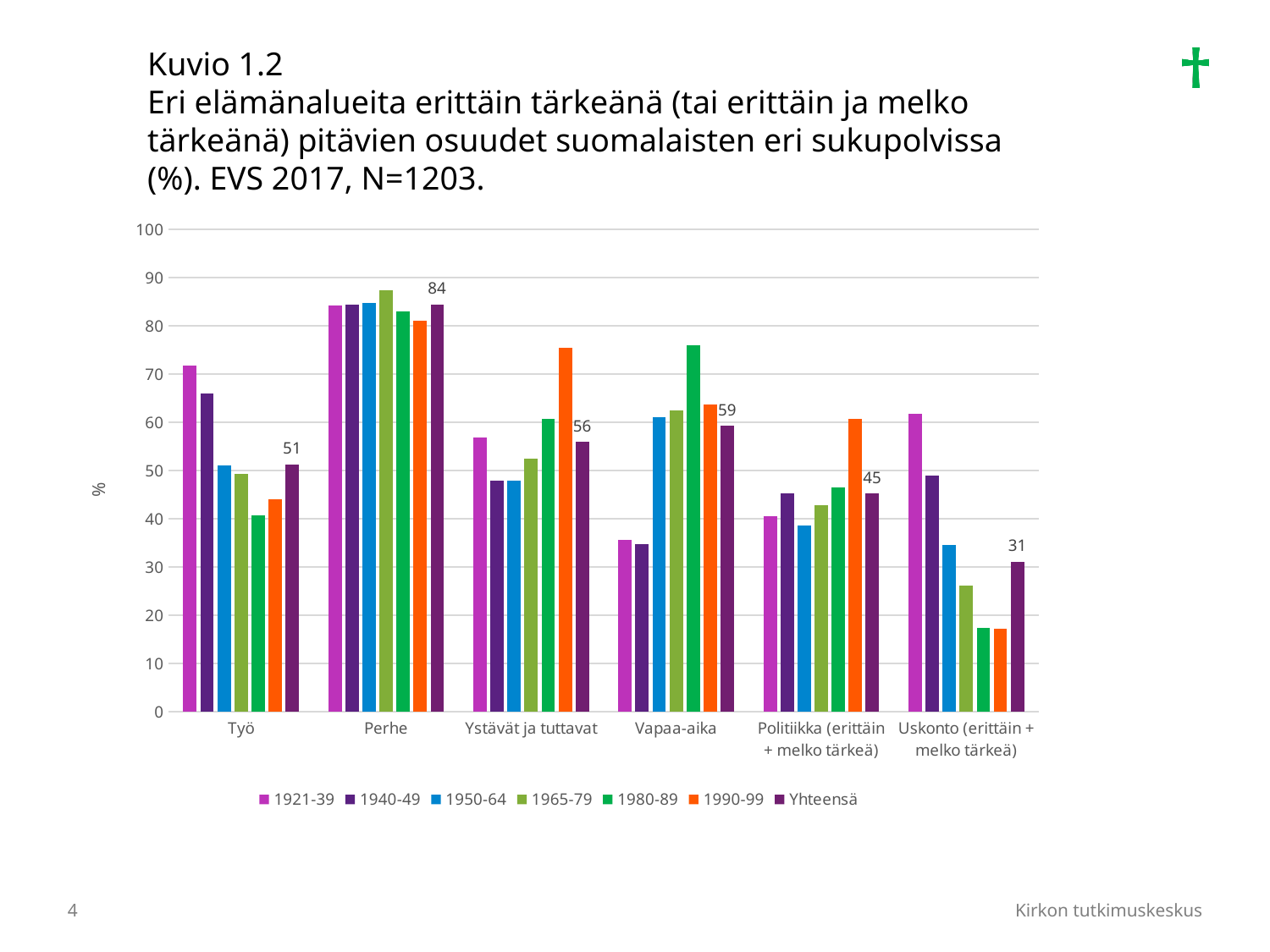
How many series does the legend list? 7 Which has the larger Yhteensä value, Työ or Ystävät ja tuttavat? Ystävät ja tuttavat What is the Yhteensä value for Perhe? 84 Among the labelled Yhteensä values, which category is lowest? Uskonto (erittäin + melko tärkeä) Among the labelled Yhteensä values, which category is highest? Perhe What is the Yhteensä value for Vapaa-aika? 59 Is the 1990-99 value for Ystävät ja tuttavat greater or less than 70? greater What is the difference between the Yhteensä values for Perhe and Uskonto (erittäin + melko tärkeä)? 53 What is the Yhteensä value for Uskonto (erittäin + melko tärkeä)? 31 What kind of chart is shown on the slide? Bar chart How many categories are shown on the x axis? 6 Is the 1980-89 value for Uskonto (erittäin + melko tärkeä) greater or less than 20? less